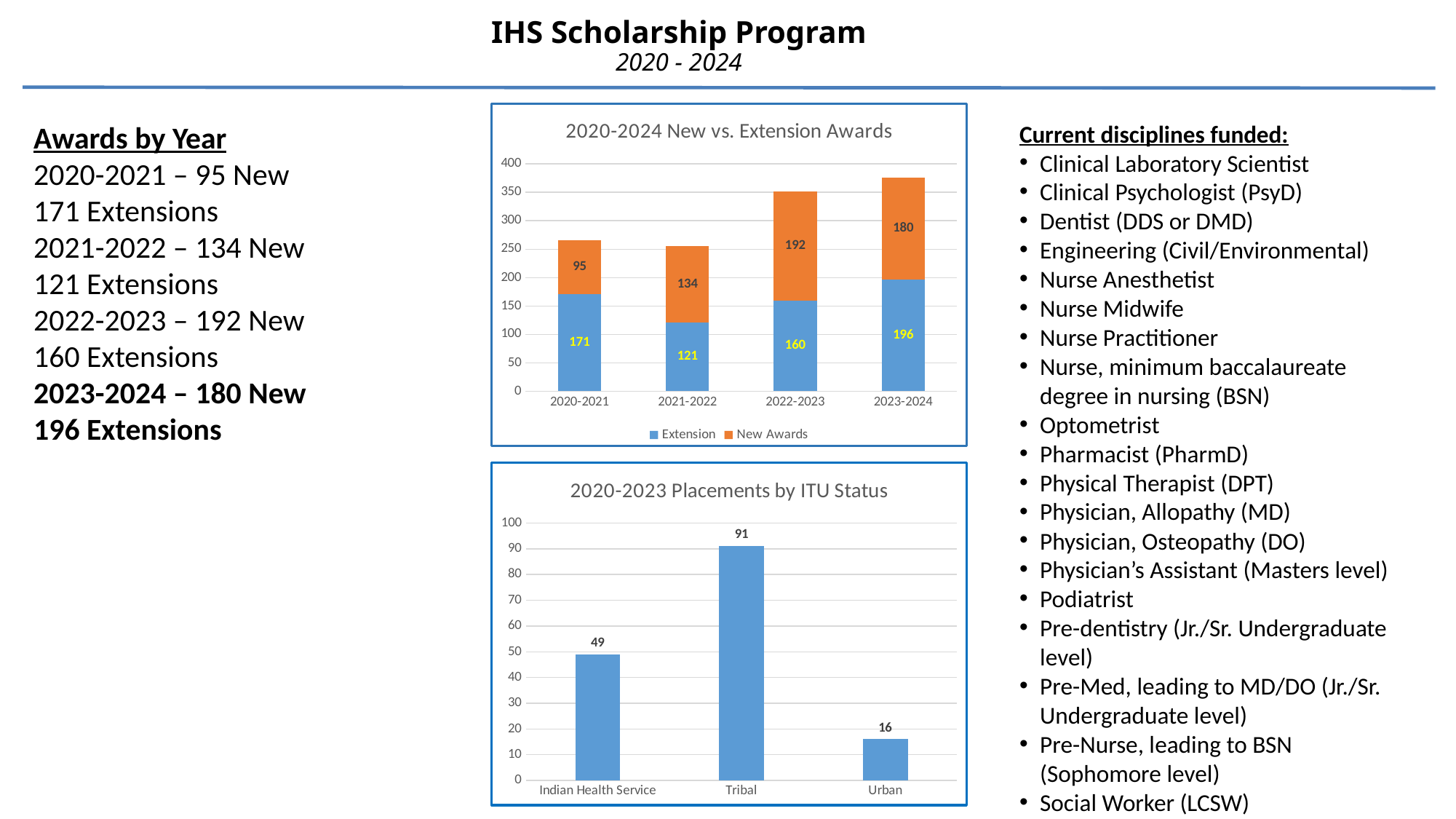
In the '2020-2023 Placements by ITU Status' chart, what is the value for Tribal? 91 In the '2020-2024 New vs. Extension Awards' chart, which colour represents New Awards? Orange In the '2020-2024 New vs. Extension Awards' chart, what is the difference between the Extension values for 2023-2024 and 2021-2022? 75 In the '2020-2023 Placements by ITU Status' chart, which category has the lowest value? Urban In the '2020-2024 New vs. Extension Awards' chart, what is the Extension value for 2020-2021? 171 In the '2020-2024 New vs. Extension Awards' chart, how many series does the legend list? 2 In the '2020-2024 New vs. Extension Awards' chart, which year has the highest New Awards value? 2022-2023 In the '2020-2023 Placements by ITU Status' chart, what is the difference between Tribal and Indian Health Service? 42 In the '2020-2024 New vs. Extension Awards' chart, what is the New Awards value for 2022-2023? 192 In the '2020-2024 New vs. Extension Awards' chart, what is the total of the stacked bar for 2021-2022? 255 What kind of chart is the '2020-2023 Placements by ITU Status' chart? Bar chart In the '2020-2024 New vs. Extension Awards' chart, what is the total of the stacked bar for 2023-2024? 376